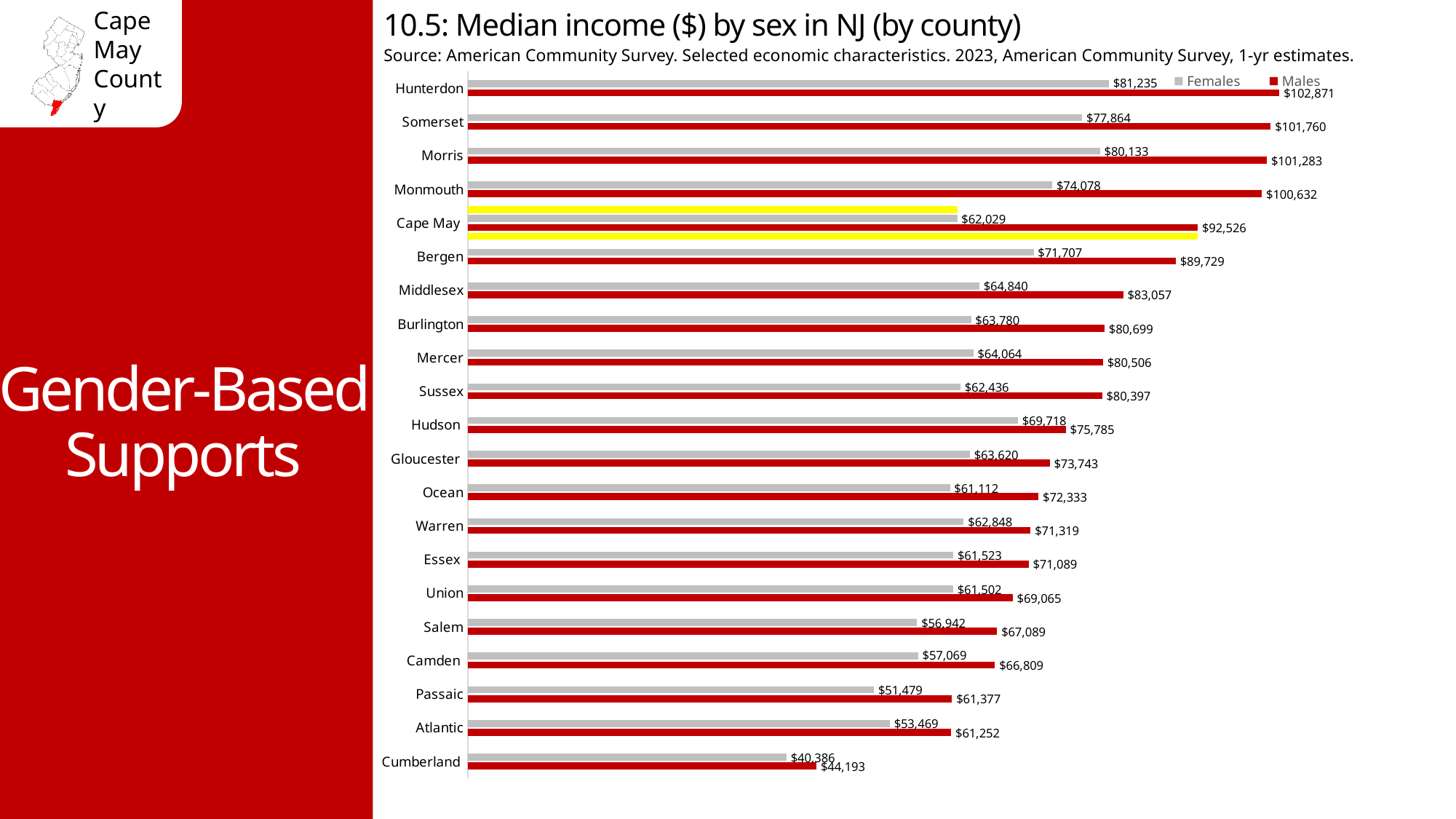
What is the difference between male and female median income in Cumberland County? $3,807 What is the median income for females in Cape May County? $62,029 Which is larger, the female median income in Hudson County or in Bergen County? Bergen County Which county has the lowest median income for females? Cumberland How many series does the legend list? 2 What is the median income for males in Cumberland County? $44,193 How many counties are shown in the chart? 21 What is the median income for females in Hunterdon County? $81,235 What is the median income for males in Cape May County? $92,526 What is the difference between male and female median income in Cape May County? $30,497 What type of chart is shown on the slide? Bar chart Which county has the highest median income for males? Hunterdon